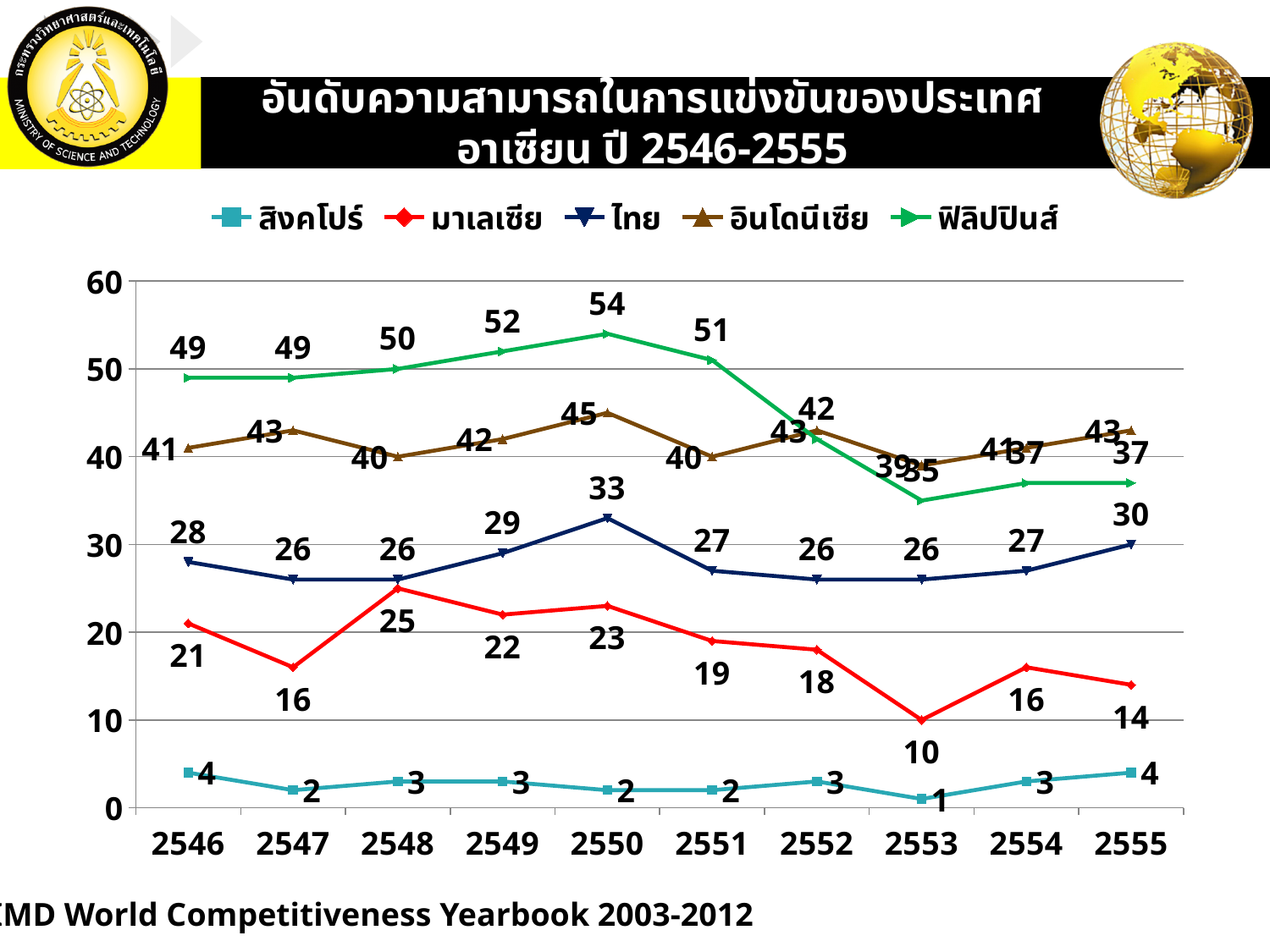
How many years are shown on the x axis? 10 What is the value for มาเลเซีย in 2553? 10 What is the value for ฟิลิปปินส์ in 2549? 52 Does the value for มาเลเซีย rise or fall from 2550 to 2553? fall In which year does สิงคโปร์ have its lowest value? 2553 What is the value for สิงคโปร์ in 2555? 4 What is the difference between the values for ไทย and มาเลเซีย in 2548? 1 Which is larger in 2546, the value for อินโดนีเซีย or the value for ฟิลิปปินส์? ฟิลิปปินส์ What type of chart is shown on the slide? line chart What is the value for ไทย in 2550? 33 How many series does the legend list? 5 In which year does ฟิลิปปินส์ reach its highest value? 2550